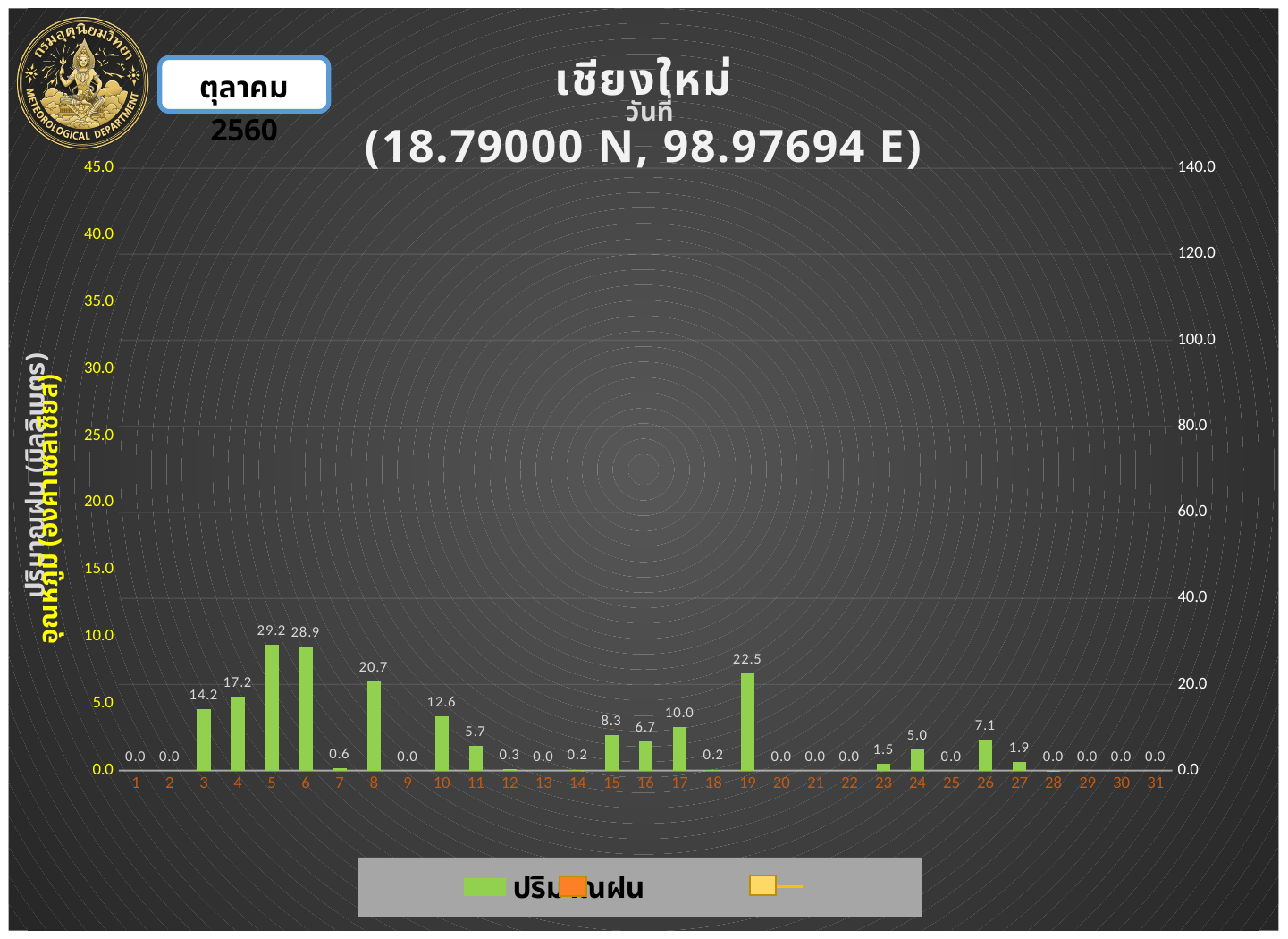
What is the rainfall value for day 26? 7.1 What kind of chart is shown on the slide? bar chart What is the name of the station shown in the chart title? เชียงใหม่ What is the rainfall value for day 19? 22.5 What is the difference between the rainfall values for day 5 and day 6? 0.3 What is the difference between the rainfall values for day 8 and day 10? 8.1 What is the rainfall value for day 8? 20.7 Which day has the highest rainfall value? 5 How many days are shown on the x axis? 31 Do the rainfall values rise or fall from day 3 to day 5? rise Which day has the larger rainfall value, day 15 or day 17? 17 Which day has the larger rainfall value, day 3 or day 4? 4